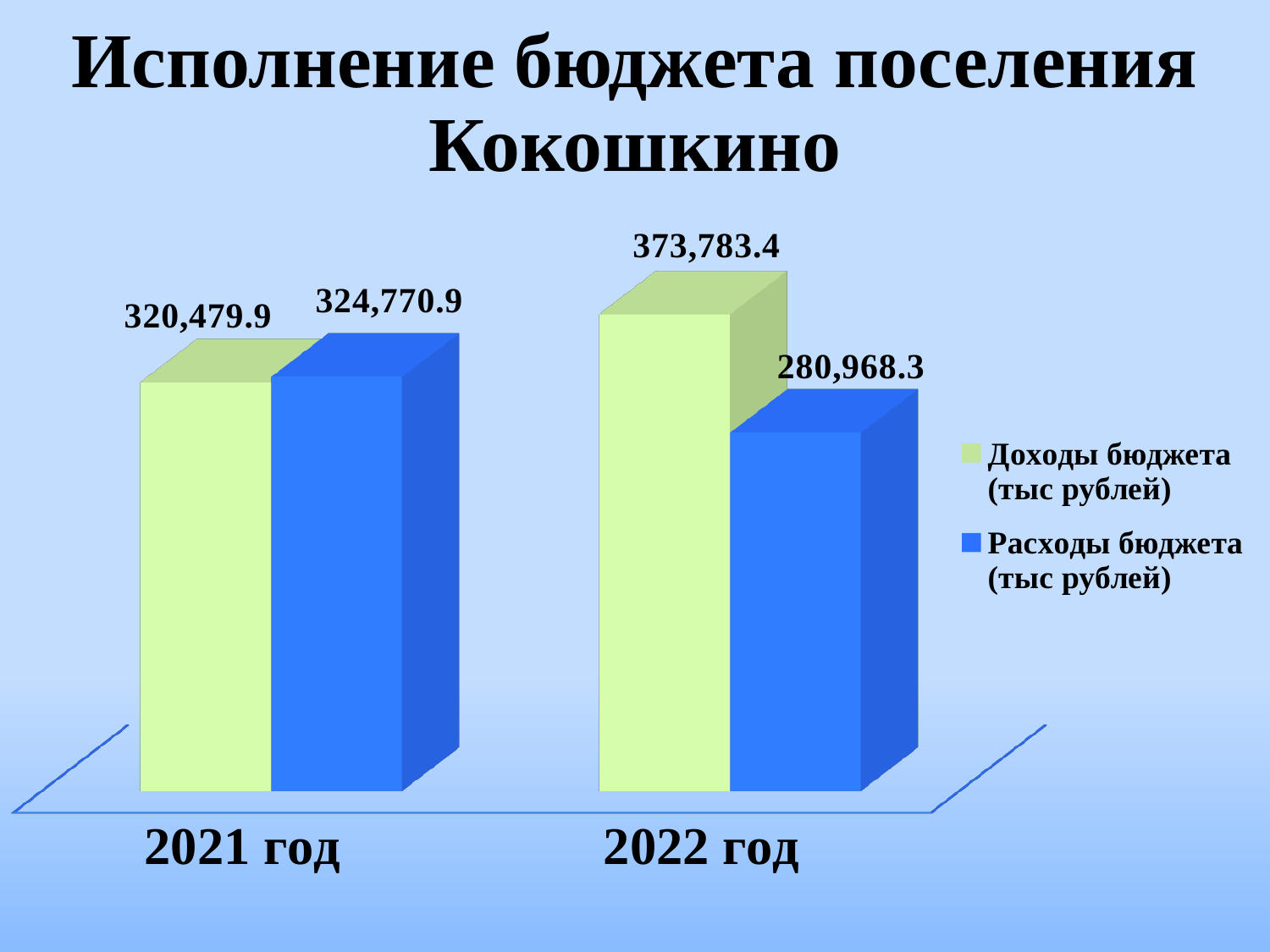
For 2021 год, which is larger: Доходы бюджета or Расходы бюджета? Расходы бюджета What is the value of Доходы бюджета (тыс рублей) for 2022 год? 373,783.4 What is the difference between Доходы бюджета and Расходы бюджета for 2022 год? 92,815.1 What is the value of Расходы бюджета (тыс рублей) for 2022 год? 280,968.3 How many series does the legend list? 2 Which bar has the lowest value on the chart? Расходы бюджета, 2022 год Do the values for Расходы бюджета rise or fall from 2021 год to 2022 год? Fall What is the value of Доходы бюджета (тыс рублей) for 2021 год? 320,479.9 What is the value of Расходы бюджета (тыс рублей) for 2021 год? 324,770.9 Which bar has the highest value on the chart? Доходы бюджета, 2022 год By how much did Доходы бюджета increase from 2021 год to 2022 год? 53,303.5 What type of chart is shown on the slide? Bar chart